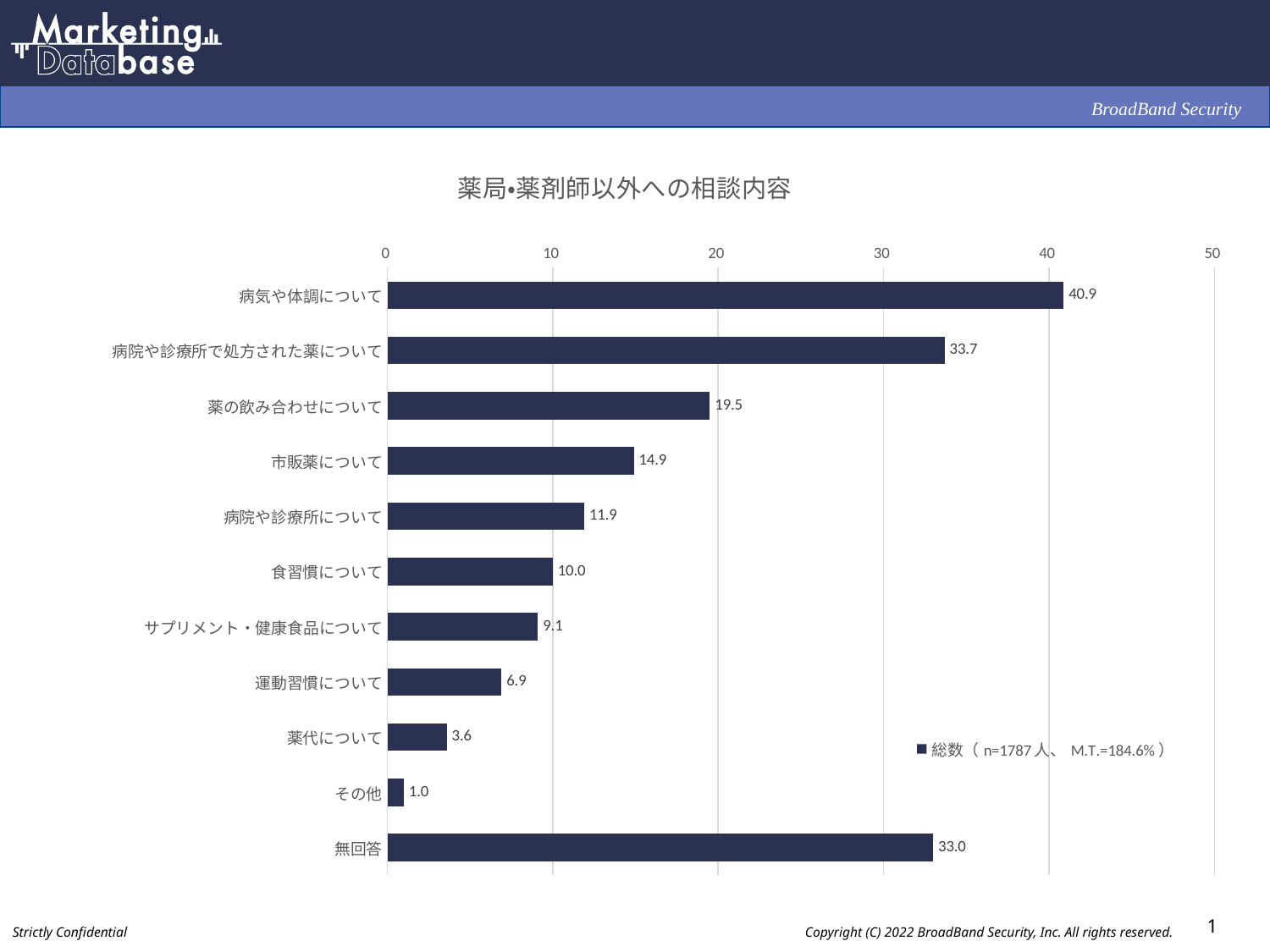
Which category has the highest value? 病気や体調について What is the difference between the values for 病院や診療所で処方された薬について and 無回答? 0.7 What is the value for 無回答? 33.0 How many categories are shown in the chart? 11 What is the title of the chart? 薬局•薬剤師以外への相談内容 Which category has the lowest value? その他 How many series does the legend list? 1 Is the value for 薬の飲み合わせについて greater or less than 20? less Which is larger, the value for 市販薬について or the value for 病院や診療所について? 市販薬について What is the value for サプリメント・健康食品について? 9.1 What kind of chart is shown on the slide? bar chart What is the value for 病気や体調について? 40.9